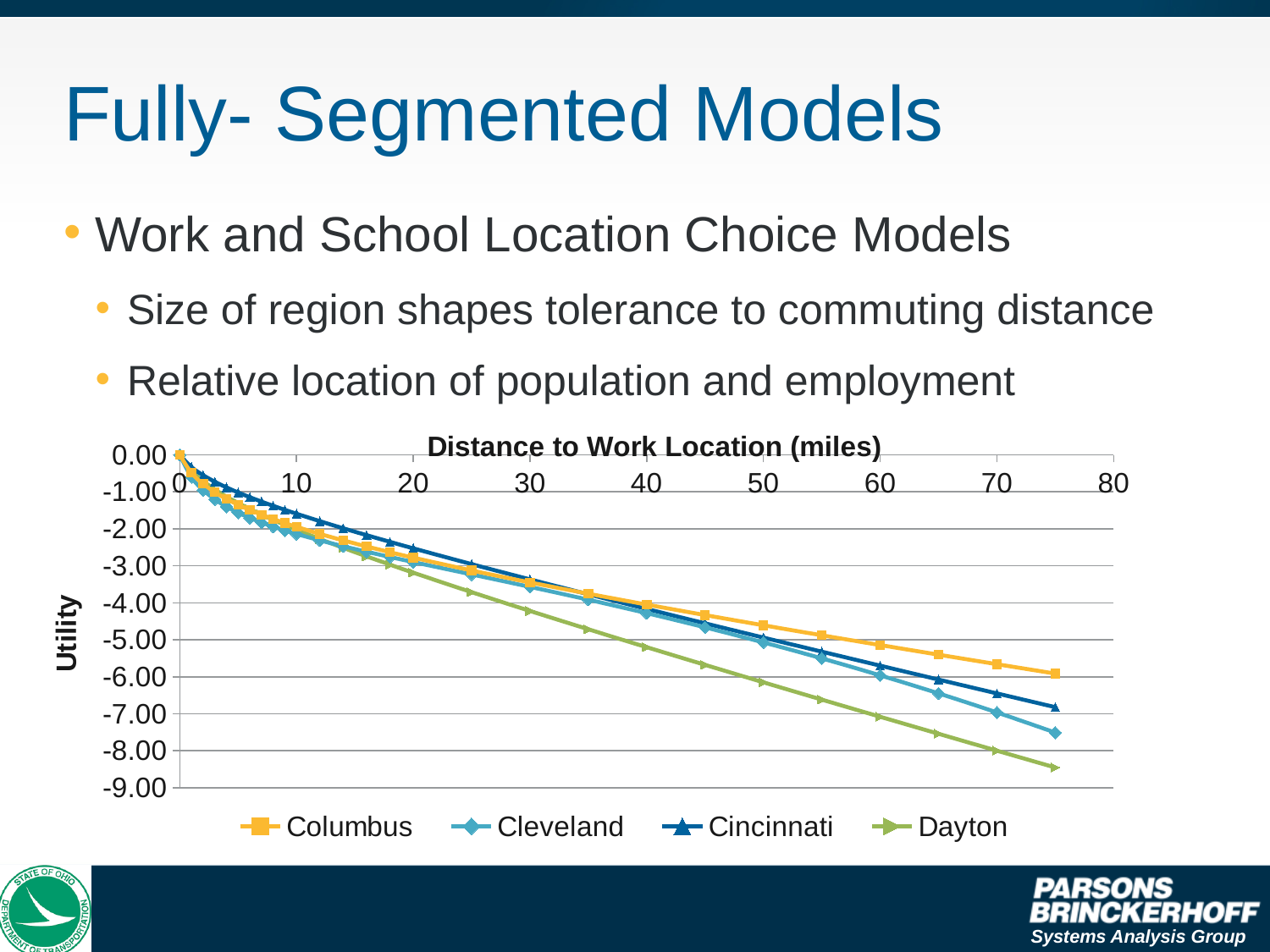
What is the title of the chart's x axis? Distance to Work Location (miles) Do the utility values rise or fall as distance to work location increases? fall Is the utility value for Dayton at around 75 miles greater or less than -8.00? less At around 75 miles, which series has the higher utility, Cincinnati or Cleveland? Cincinnati How many series does the chart legend list? 4 What is the utility value for Columbus at a distance of 0 miles? 0.00 Which series has the highest utility at the far right end of the chart (around 75 miles)? Columbus Is the utility value for Columbus at 50 miles greater or less than -5.00? greater What kind of chart is shown on the slide? line chart Which series has the lowest utility at the far right end of the chart (around 75 miles)? Dayton What is the title of the chart's y axis? Utility